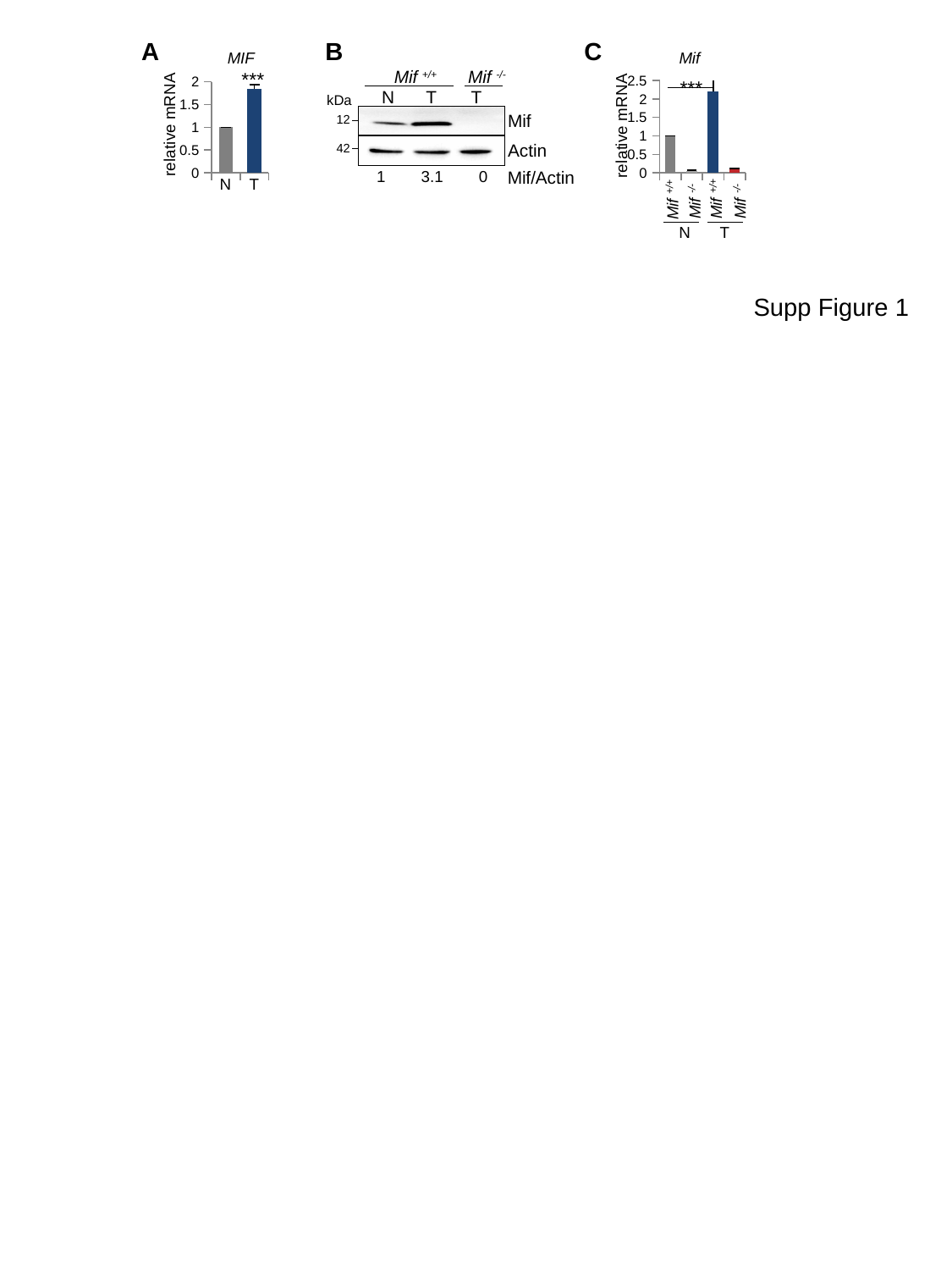
In chart A (MIF), which bar is higher, N or T? T In chart A, what is the title of the chart? MIF In chart C (Mif), how many bars are plotted? 4 In chart A (MIF), how many bars are plotted? 2 In chart C (Mif), which bar is the highest? Mif +/+ T In chart C (Mif), what is the relative mRNA value for Mif +/+ N? 1 In chart A (MIF), is the value for T greater or less than 1.5? greater In chart C (Mif), what is the y-axis label? relative mRNA In chart C (Mif), within the N group, which bar is higher, Mif +/+ or Mif -/-? Mif +/+ In chart A (MIF), what kind of chart is shown? bar chart In chart A (MIF), what is the relative mRNA value for N? 1 In chart C (Mif), is the value for Mif +/+ T greater or less than 2? greater